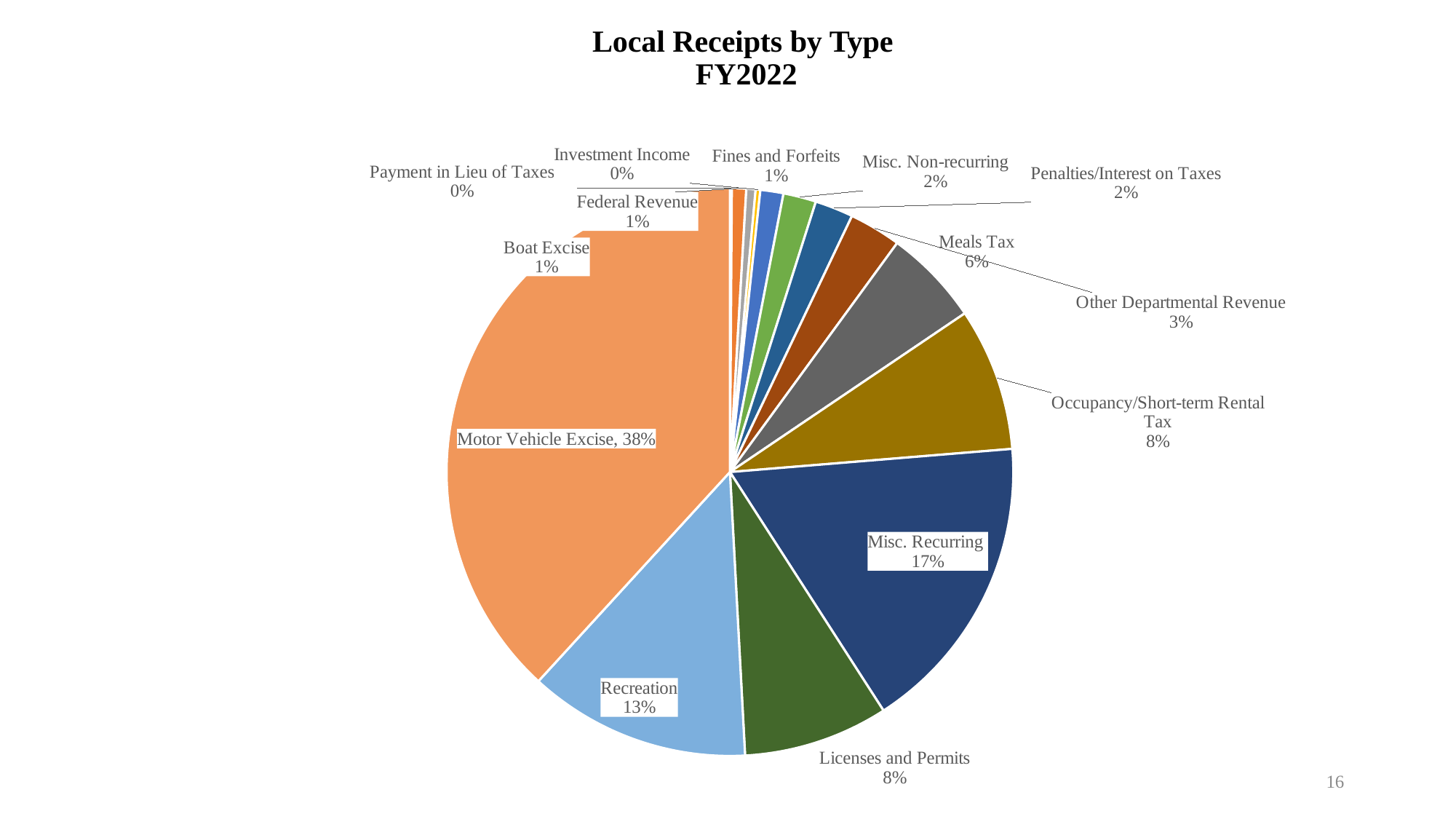
What is the title of the chart? Local Receipts by Type FY2022 What percentage is shown for Occupancy/Short-term Rental Tax? 8% How many categories are shown in the pie chart? 14 What type of chart is shown on the slide? Pie chart What is the difference in percentage points between Meals Tax and Other Departmental Revenue? 3 Which category has the largest share of local receipts? Motor Vehicle Excise What percentage is shown for Misc. Recurring? 17% What share of local receipts does Motor Vehicle Excise account for? 38% What percentage is shown for Meals Tax? 6% What is the difference in percentage points between Motor Vehicle Excise and Misc. Recurring? 21 What percentage is shown for Recreation? 13% Which is larger, the share for Recreation or the share for Licenses and Permits? Recreation